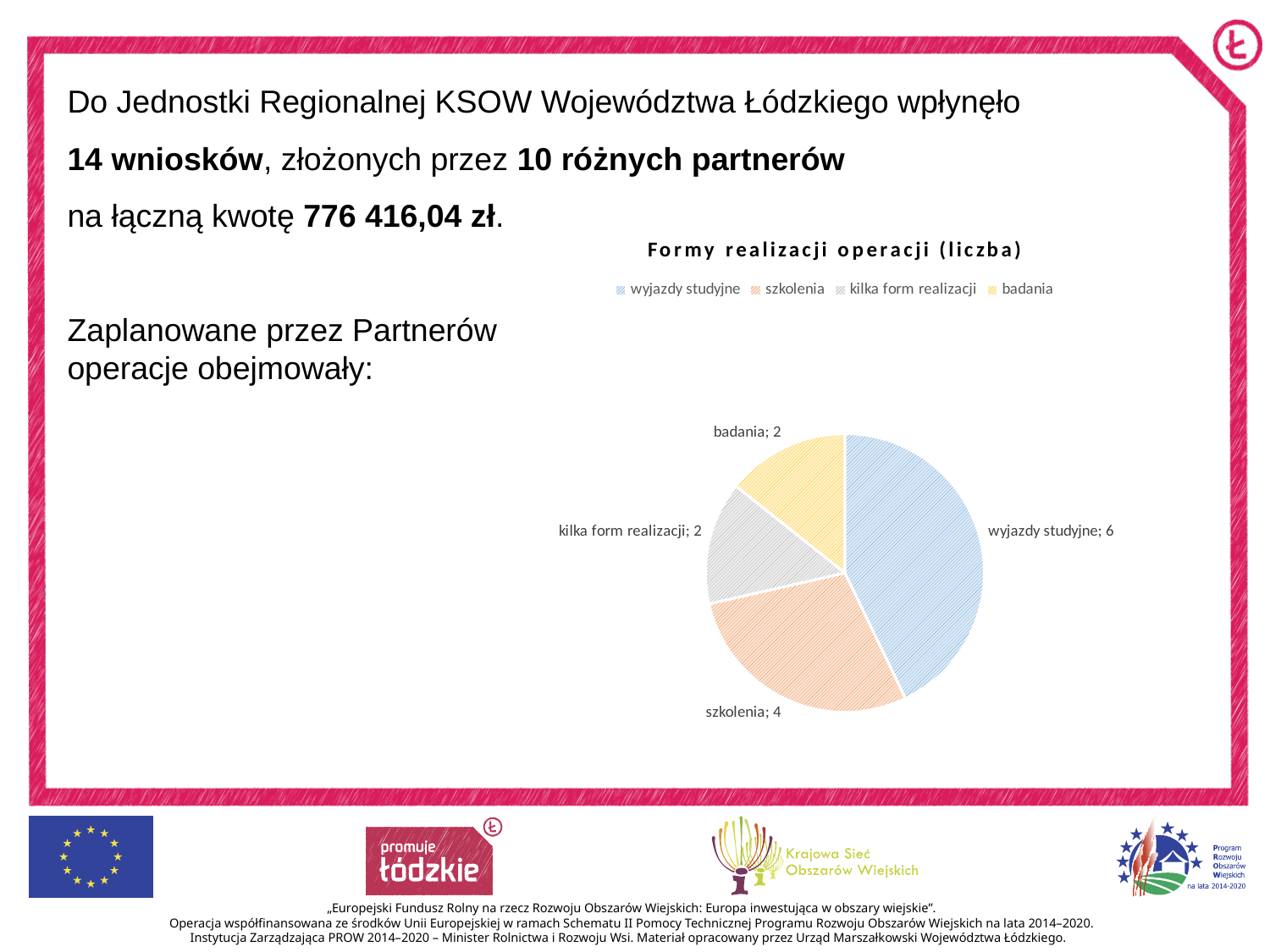
What type of chart is shown on the slide? pie chart What is the title of the chart? Formy realizacji operacji (liczba) What is the difference between the values for wyjazdy studyjne and szkolenia? 2 What is the value for badania? 2 How many entries does the chart legend list? 4 What is the total of all slices in the pie chart? 14 What is the value for wyjazdy studyjne? 6 What is the value for szkolenia? 4 Which is larger, the value for szkolenia or the value for kilka form realizacji? szkolenia Which category has the largest slice of the pie? wyjazdy studyjne How many slices does the pie chart have? 4